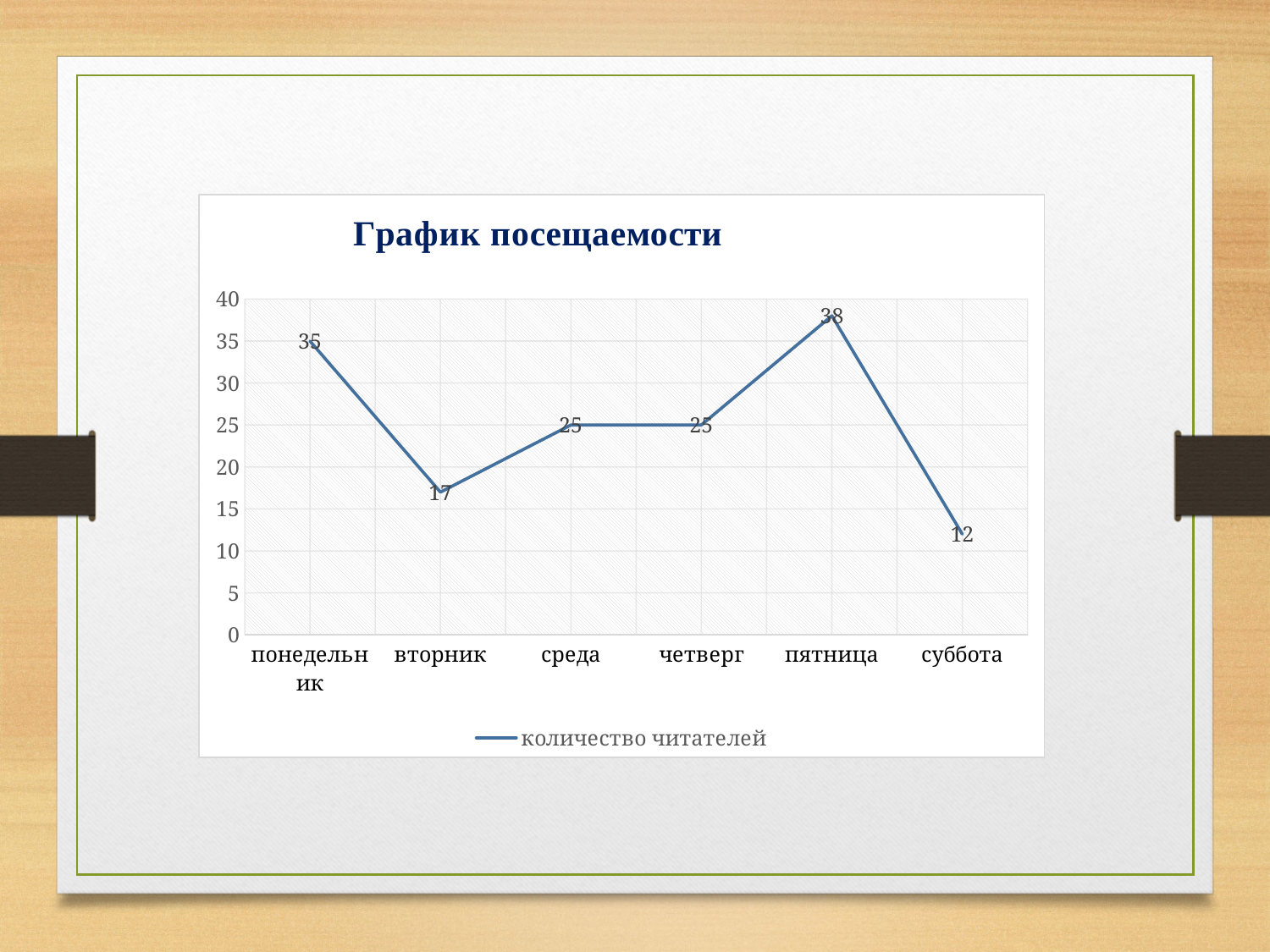
Which is larger, the value for понедельник or the value for вторник? понедельник What is the title of the chart? График посещаемости What kind of chart is shown? line chart What is the value for понедельник? 35 Which day has the lowest value? суббота What is the value for вторник? 17 How many days are plotted on the chart? 6 What is the difference between the values for пятница and суббота? 26 Is the value for пятница greater or less than 35? greater What is the value for суббота? 12 How many series does the legend list? 1 Which day has the highest value? пятница